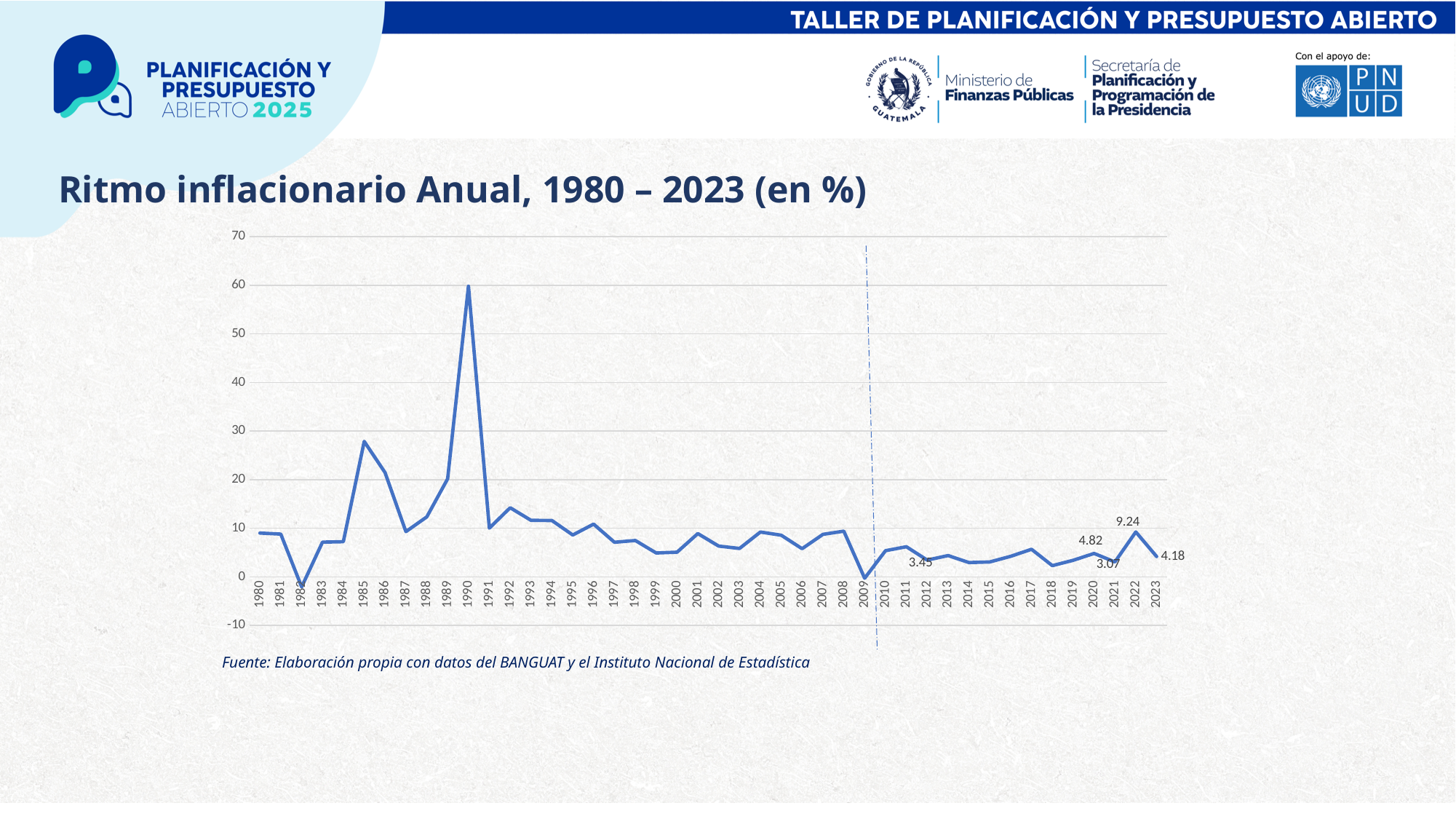
By how much did the inflation rate fall from 2022 to 2023? 5.06 In which year does the inflation rate reach its highest point? 1990 Which year had the higher inflation rate, 2020 or 2021? 2020 How many years are plotted on the x axis? 44 In which year does the inflation rate reach its lowest point? 1982 What is the annual inflation rate shown for 2021? 3.07 What is the annual inflation rate shown for 2022? 9.24 What is the annual inflation rate shown for 2023? 4.18 What kind of chart is shown on the slide? line chart Does the inflation rate rise or fall from 2022 to 2023? fall Is the inflation rate for 1985 greater or less than 20? greater What is the annual inflation rate shown for 2020? 4.82